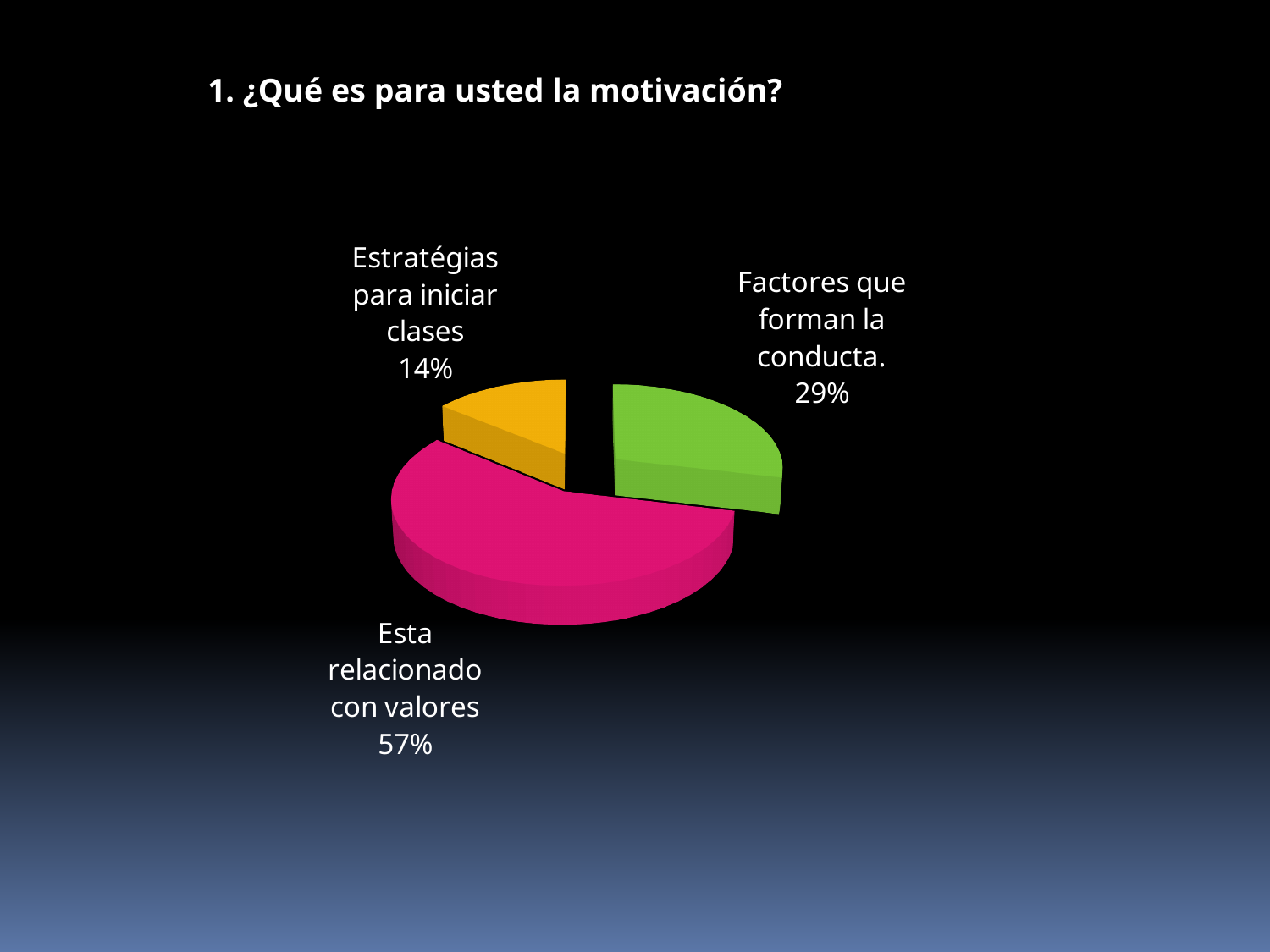
What share of the pie does "Factores que forman la conducta." represent? 29% Which is larger: the slice for "Factores que forman la conducta." or the slice for "Estratégias para iniciar clases"? Factores que forman la conducta. How many categories are shown in the pie chart? 3 What share of the pie does "Esta relacionado con valores" represent? 57% What is the difference in percentage points between "Esta relacionado con valores" and "Factores que forman la conducta."? 28 What is the title of the slide above the chart? 1. ¿Qué es para usted la motivación? What colour is the slice for "Esta relacionado con valores"? Pink Which category has the largest slice of the pie? Esta relacionado con valores What is the difference in percentage points between "Factores que forman la conducta." and "Estratégias para iniciar clases"? 15 What share of the pie does "Estratégias para iniciar clases" represent? 14% Which category has the smallest slice of the pie? Estratégias para iniciar clases What kind of chart is shown on the slide? Pie chart